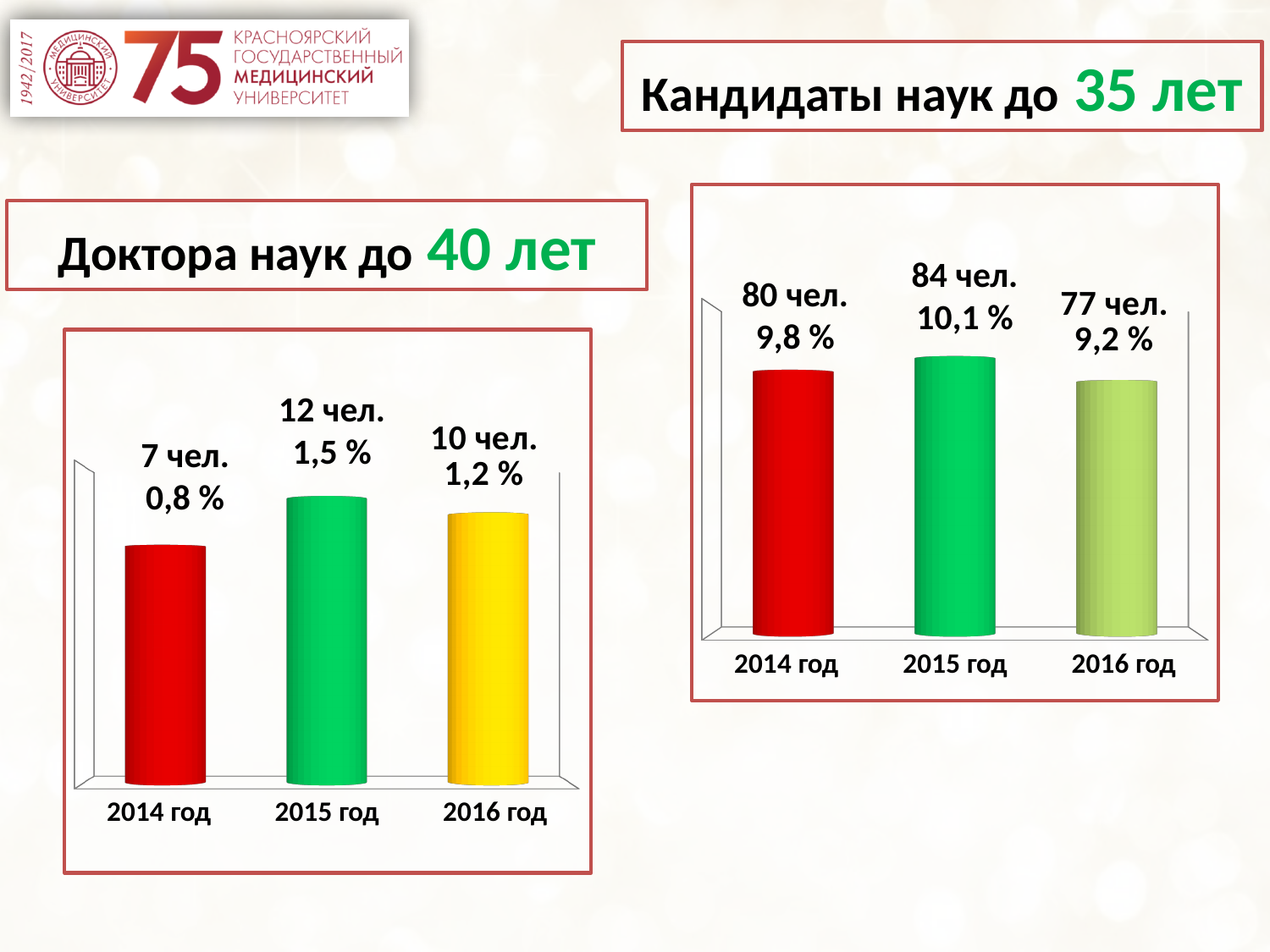
In the chart 'Кандидаты наук до 35 лет', which is larger, the value for 2014 год or 2015 год? 2015 год In the chart 'Доктора наук до 40 лет', which year has the highest value? 2015 год In the chart 'Доктора наук до 40 лет', what is the difference in number of people between 2015 год and 2014 год? 5 чел. In the chart 'Доктора наук до 40 лет', what colour is the bar for 2016 год? Yellow In the chart 'Доктора наук до 40 лет', what percentage is shown for 2014 год? 0,8 % How many categories are shown in the chart 'Доктора наук до 40 лет'? 3 In the chart 'Кандидаты наук до 35 лет', what is the difference in number of people between 2014 год and 2016 год? 3 чел. In the chart 'Доктора наук до 40 лет', how many people are shown for 2015 год? 12 чел. In the chart 'Кандидаты наук до 35 лет', how many people are shown for 2016 год? 77 чел. In the chart 'Кандидаты наук до 35 лет', what percentage is shown for 2015 год? 10,1 % In the chart 'Кандидаты наук до 35 лет', which year has the lowest value? 2016 год What type of chart is 'Кандидаты наук до 35 лет'? Bar chart